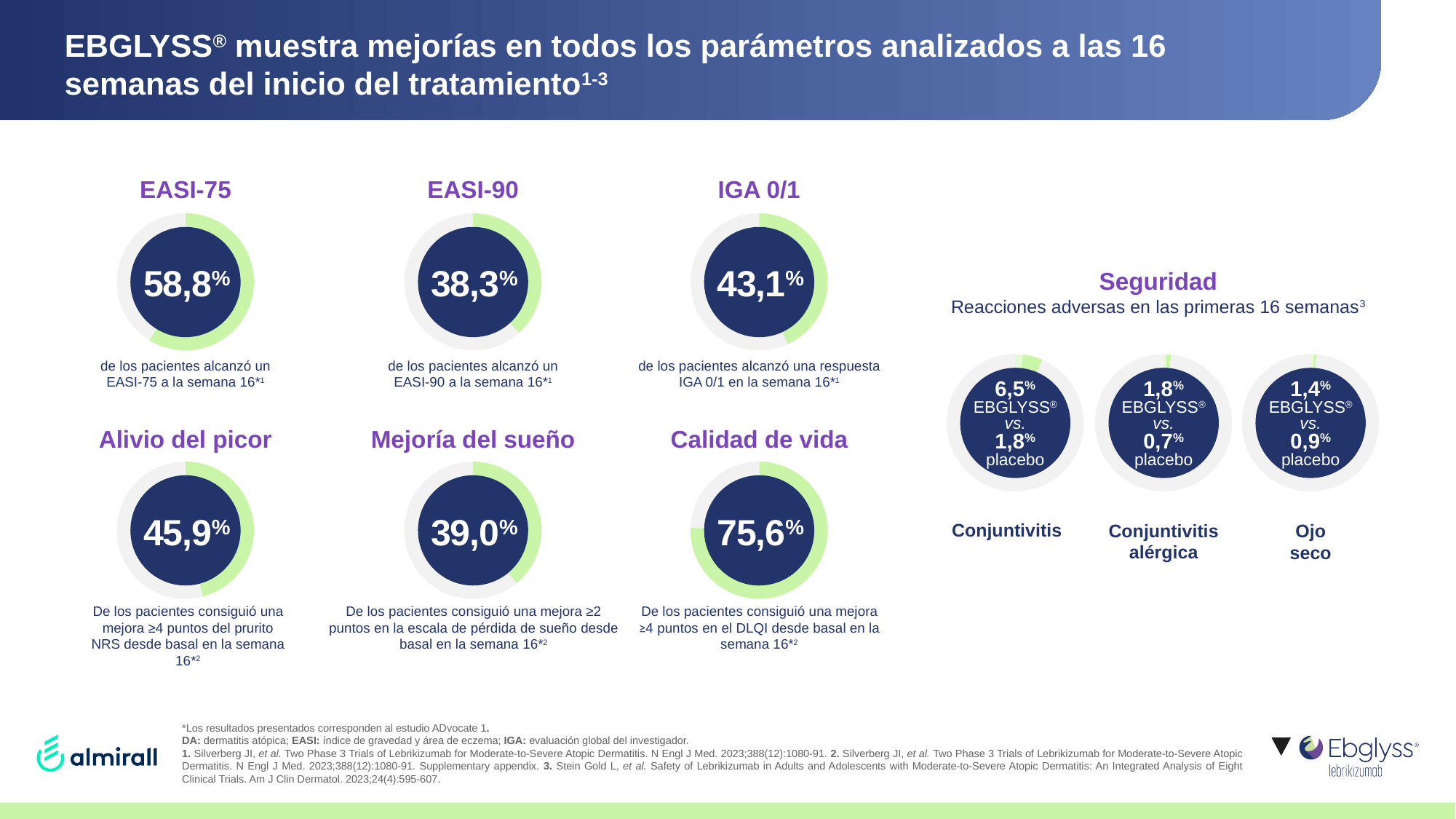
In the Seguridad section, what is the EBGLYSS rate for Conjuntivitis? 6,5% In the Seguridad section, what is the placebo rate for Ojo seco? 0,9% What is the difference between the EASI-75 percentage and the EASI-90 percentage? 20,5% In the EASI-90 chart, what percentage of patients achieved EASI-90 at week 16? 38,3% In the EASI-75 chart, what percentage of patients achieved EASI-75 at week 16? 58,8% Among the six efficacy ring charts, which shows the lowest percentage? EASI-90 In the Seguridad section, what is the difference between the EBGLYSS and placebo rates for Conjuntivitis alérgica? 1,1% In the Calidad de vida chart, what percentage of patients achieved a ≥4-point DLQI improvement? 75,6% In the IGA 0/1 chart, what percentage of patients achieved an IGA 0/1 response at week 16? 43,1% Which is larger, the Alivio del picor percentage or the Mejoría del sueño percentage? Alivio del picor How many adverse reactions are shown in the Seguridad section? 3 Among the six efficacy ring charts (EASI-75, EASI-90, IGA 0/1, Alivio del picor, Mejoría del sueño, Calidad de vida), which shows the highest percentage? Calidad de vida